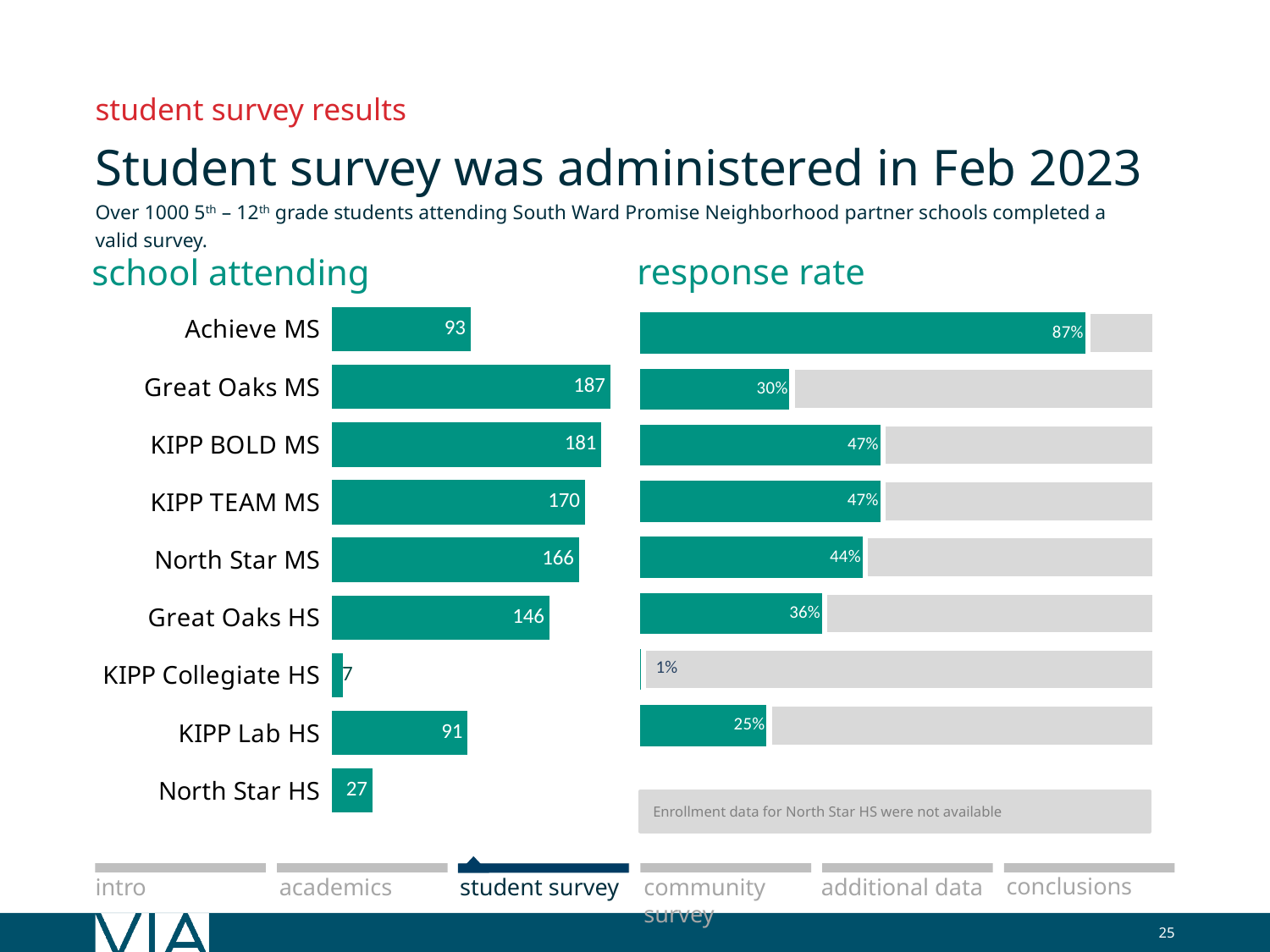
In the "school attending" chart, which school has the lowest value? KIPP Collegiate HS In the "school attending" chart, which is larger, Achieve MS or North Star HS? Achieve MS In the "response rate" chart, which school has the lowest response rate? KIPP Collegiate HS In the "school attending" chart, what is the difference between KIPP BOLD MS and KIPP TEAM MS? 11 In the "response rate" chart, what is the response rate for Great Oaks HS? 36% How many schools are listed in the "school attending" chart? 9 In the "school attending" chart, how many students attended Great Oaks MS? 187 In the "response rate" chart, what is the difference between the response rates of Achieve MS and Great Oaks MS? 57% In the "school attending" chart, what is the value for KIPP Lab HS? 91 In the "response rate" chart, what is the response rate for Achieve MS? 87% In the "school attending" chart, which school has the highest value? Great Oaks MS What type of chart is the "school attending" chart? Bar chart